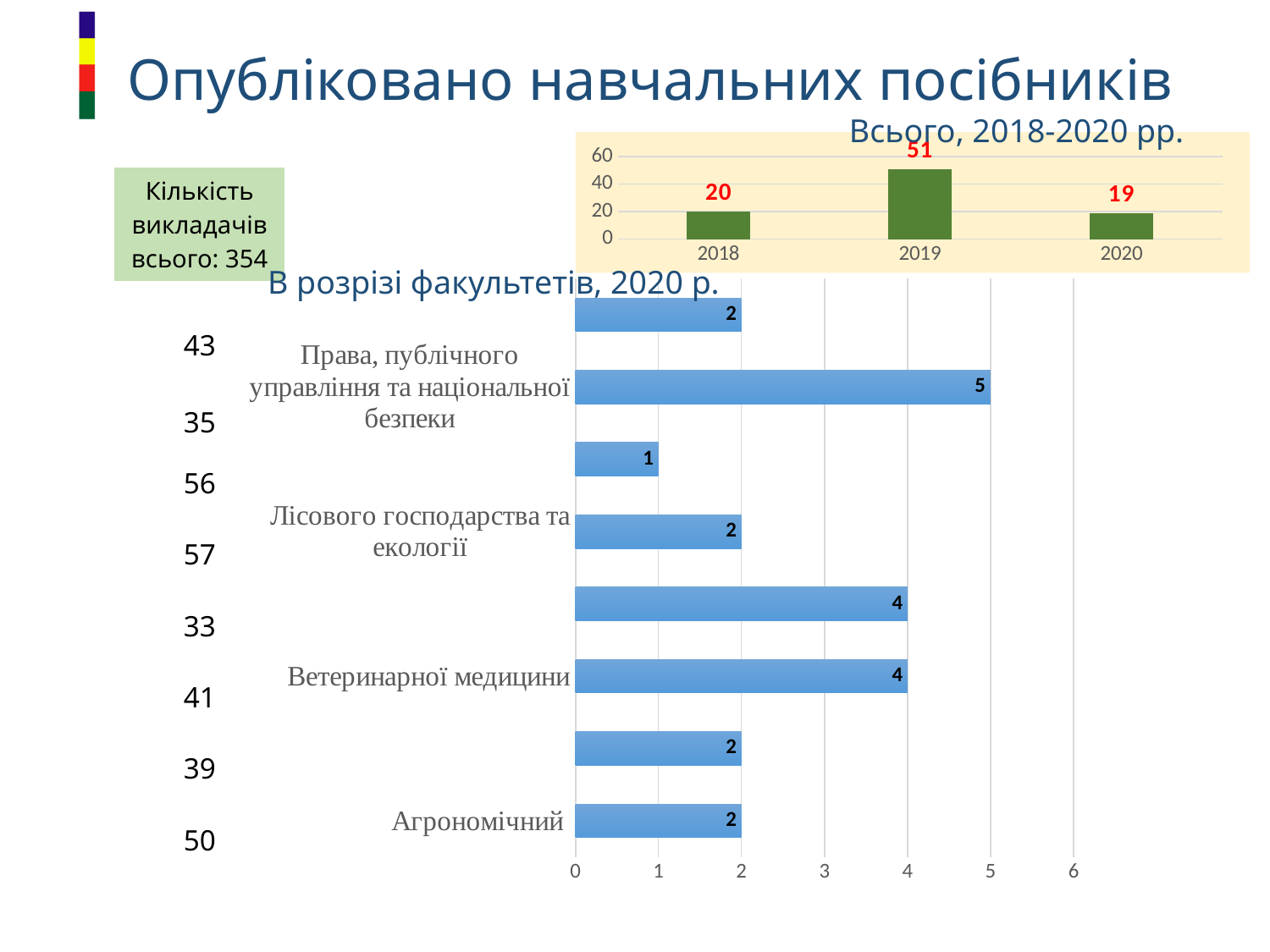
In the chart titled "В розрізі факультетів, 2020 р.", which is larger: the value for Ветеринарної медицини or the value for Лісового господарства та екології? Ветеринарної медицини In the chart titled "Всього, 2018-2020 рр.", which year has the lowest value? 2020 In the chart titled "В розрізі факультетів, 2020 р.", what is the value for Ветеринарної медицини? 4 In the chart titled "Всього, 2018-2020 рр.", how many years are shown on the x axis? 3 In the chart titled "Всього, 2018-2020 рр.", what is the value for 2019? 51 In the chart titled "Всього, 2018-2020 рр.", which year has the highest value? 2019 In the chart titled "Всього, 2018-2020 рр.", what is the difference between the values for 2019 and 2020? 32 What kind of chart is the one titled "Всього, 2018-2020 рр."? bar chart In the chart titled "Всього, 2018-2020 рр.", what is the value for 2018? 20 In the chart titled "В розрізі факультетів, 2020 р.", how many bars are plotted? 8 In the chart titled "В розрізі факультетів, 2020 р.", what is the value for Права, публічного управління та національної безпеки? 5 In the chart titled "В розрізі факультетів, 2020 р.", what is the value for Агрономічний? 2